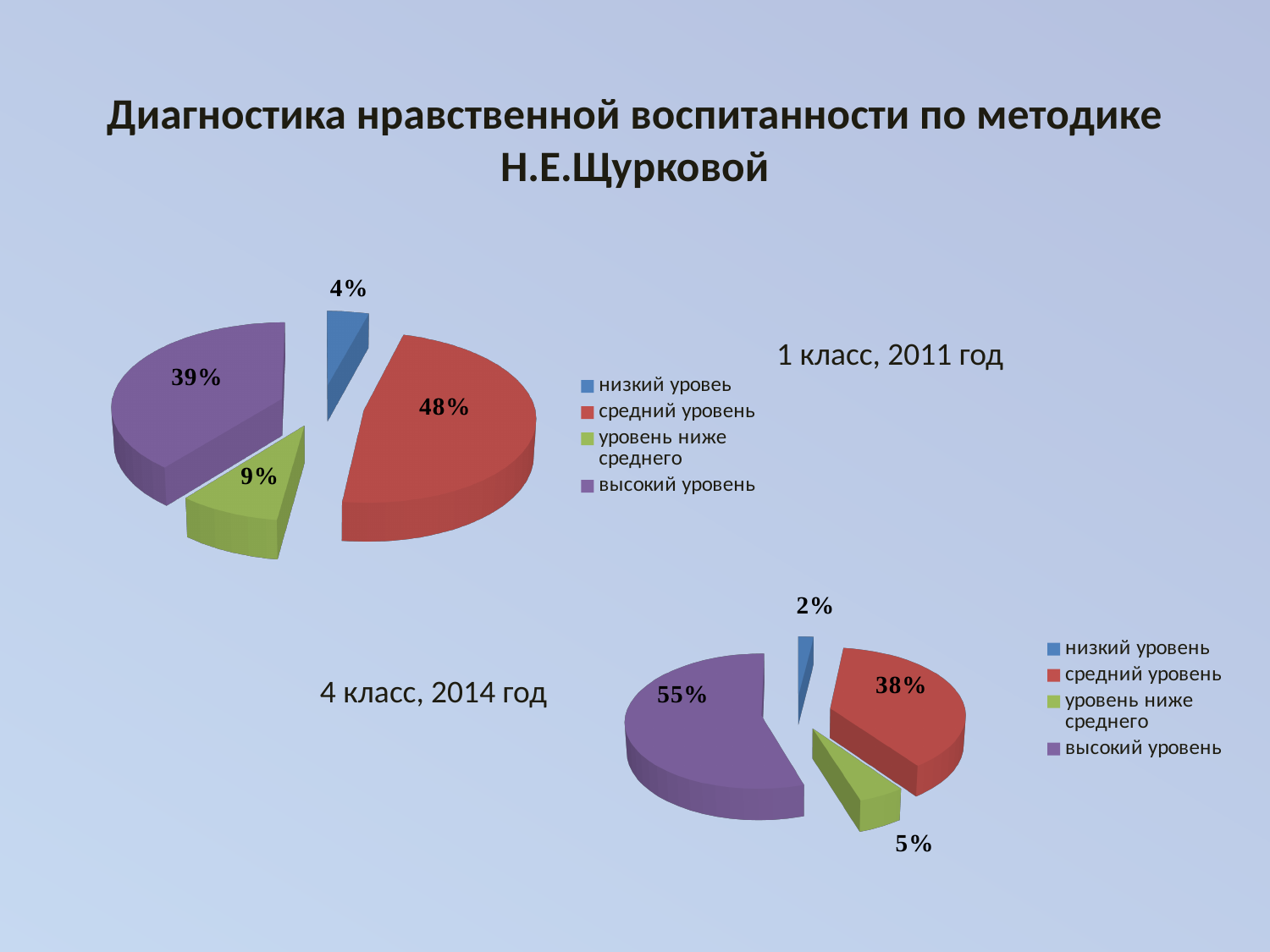
What is the difference between the share of высокий уровень in the 4 класс, 2014 год chart and in the 1 класс, 2011 год chart? 16% How many slices does the pie chart for 4 класс, 2014 год have? 4 In the pie chart for 4 класс, 2014 год, what share is labelled for уровень ниже среднего? 5% What type of chart is used for 1 класс, 2011 год? pie chart In the pie chart for 1 класс, 2011 год, what share is labelled for средний уровень? 48% In the pie chart for 4 класс, 2014 год, which category has the smallest slice? низкий уровень In the pie chart for 1 класс, 2011 год, what share is labelled for высокий уровень? 39% Which is larger: the share of средний уровень in the 1 класс, 2011 год chart or in the 4 класс, 2014 год chart? 1 класс, 2011 год In the pie chart for 4 класс, 2014 год, which category has the largest slice? высокий уровень In the pie chart for 4 класс, 2014 год, what share is labelled for низкий уровень? 2% In the pie chart for 1 класс, 2011 год, which category has the largest slice? средний уровень In the pie chart for 1 класс, 2011 год, which category has the smallest slice? низкий уровень